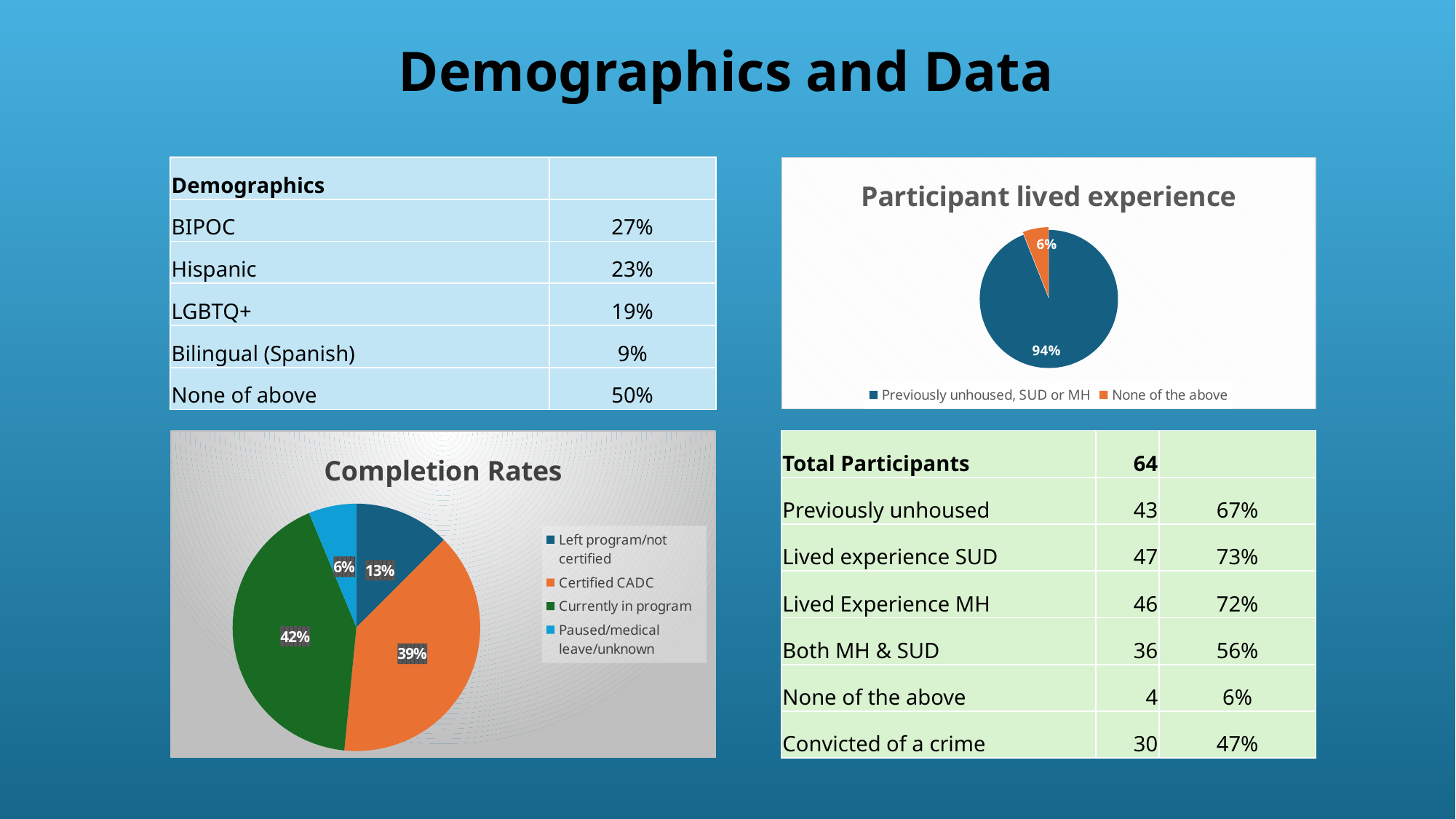
In the "Completion Rates" chart, which category has the smallest slice? Paused/medical leave/unknown How many categories does the legend of the "Completion Rates" chart list? 4 In the "Completion Rates" chart, what colour is the "Certified CADC" slice? Orange In the "Completion Rates" chart, what share of the pie is "Left program/not certified"? 13% What kind of chart is the "Participant lived experience" chart? Pie chart In the "Participant lived experience" chart, what share of the pie is "None of the above"? 6% In the "Completion Rates" chart, what is the difference between the "Currently in program" and "Certified CADC" shares? 3% In the "Completion Rates" chart, what share of the pie is "Currently in program"? 42% How many slices does the "Participant lived experience" pie chart have? 2 In the "Completion Rates" chart, which category has the largest slice? Currently in program